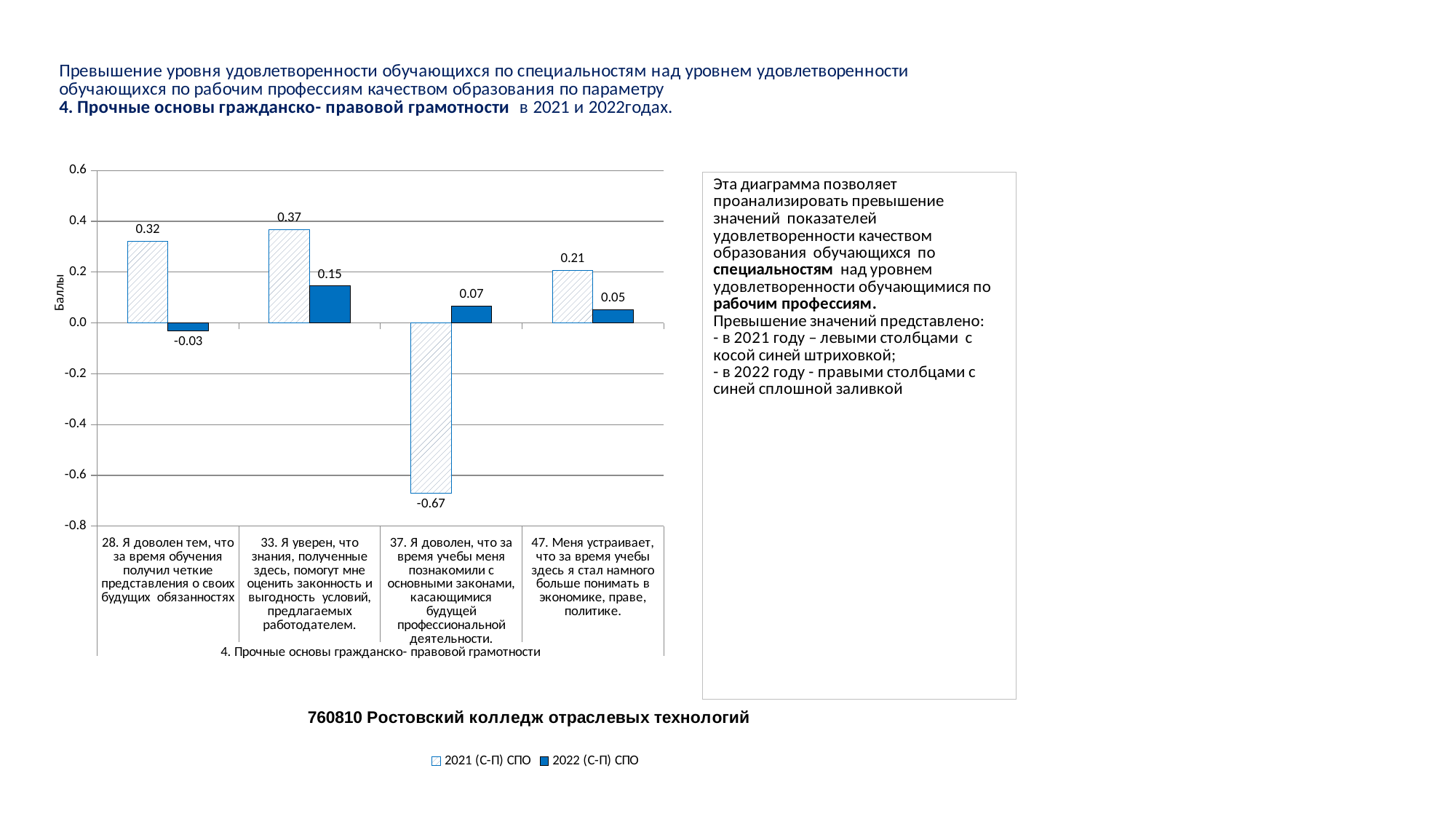
Which category has the lowest value in the 2022 (С-П) СПО series? 28. Я доволен тем, что за время обучения получил четкие представления о своих будущих обязанностях What type of chart is shown on the slide? bar chart What is the label of the vertical axis? Баллы What is the difference between the 2021 and 2022 values for category 33? 0.22 What is the value of the 2021 (С-П) СПО series for category 28 (Я доволен тем, что за время обучения получил четкие представления о своих будущих обязанностях)? 0.32 What is the value of the 2021 (С-П) СПО series for category 37? -0.67 How many categories (questions) are shown on the x axis? 4 Which category has the highest value in the 2021 (С-П) СПО series? 33. Я уверен, что знания, полученные здесь, помогут мне оценить законность и выгодность условий, предлагаемых работодателем. How many series does the legend list? 2 For category 47, which series has the larger value, 2021 (С-П) СПО or 2022 (С-П) СПО? 2021 (С-П) СПО What is the value of the 2022 (С-П) СПО series for category 37 (Я доволен, что за время учебы меня познакомили с основными законами...)? 0.07 What is the name of the second series in the legend? 2022 (С-П) СПО